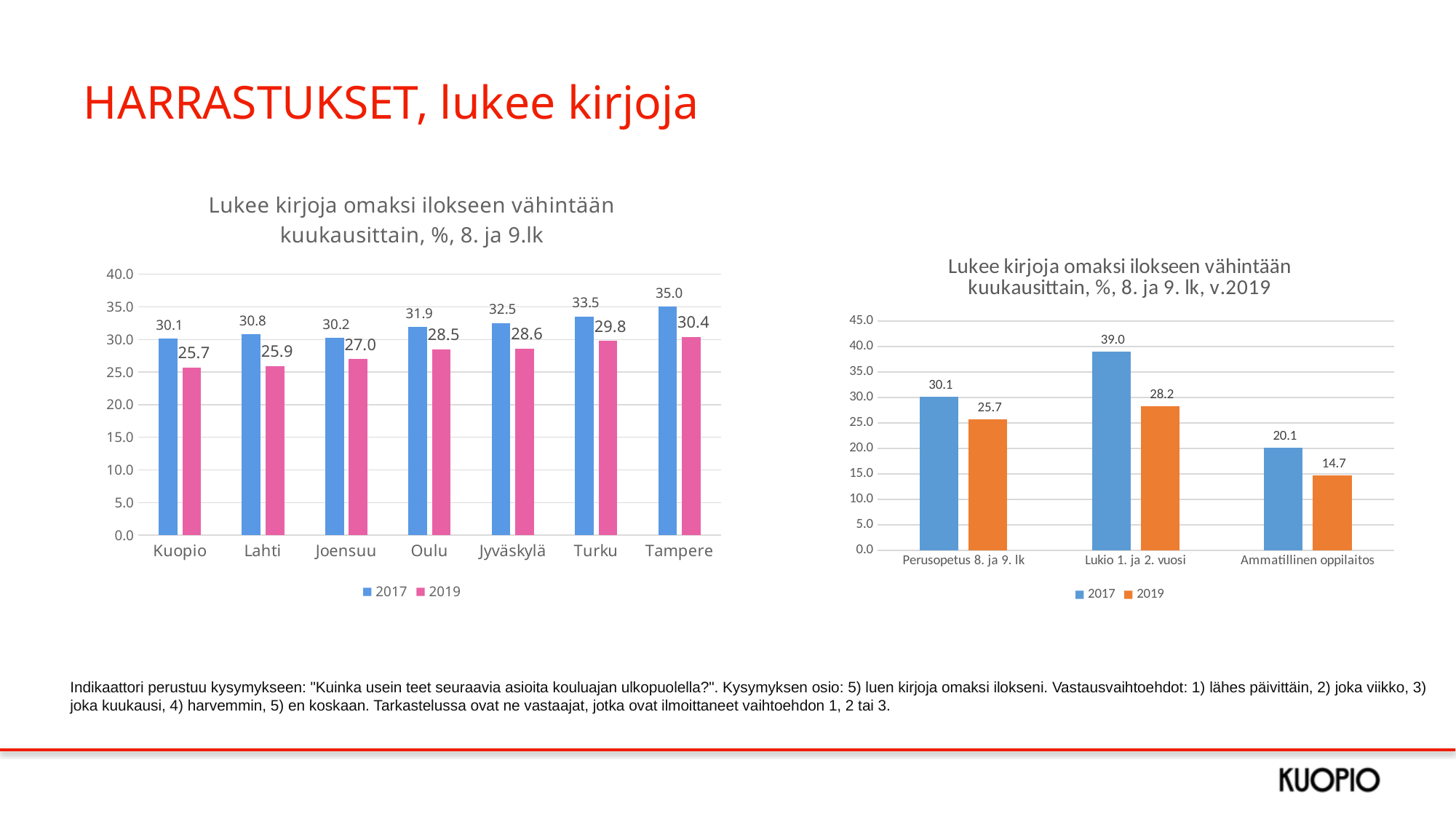
In the right chart (school types), what is the 2017 value for Lukio 1. ja 2. vuosi? 39.0 In the right chart (school types), what is the difference between the 2017 and 2019 values for Ammatillinen oppilaitos? 5.4 In the left chart (cities), what is the 2017 value for Oulu? 31.9 In the left chart (cities), is the 2019 value for Lahti greater or less than 30.0? less In the right chart (school types), which category has the lowest 2019 value? Ammatillinen oppilaitos In the left chart (cities), what is the difference between the 2017 and 2019 values for Kuopio? 4.4 In the left chart (cities), what is the 2019 value for Turku? 29.8 In the left chart (cities), which city has the highest 2017 value? Tampere In the left chart (cities), which city has the lowest 2019 value? Kuopio In the left chart (cities), how many cities are shown on the x axis? 7 In the right chart (school types), how many series does the legend list? 2 What kind of chart is the right chart (school types)? Bar chart